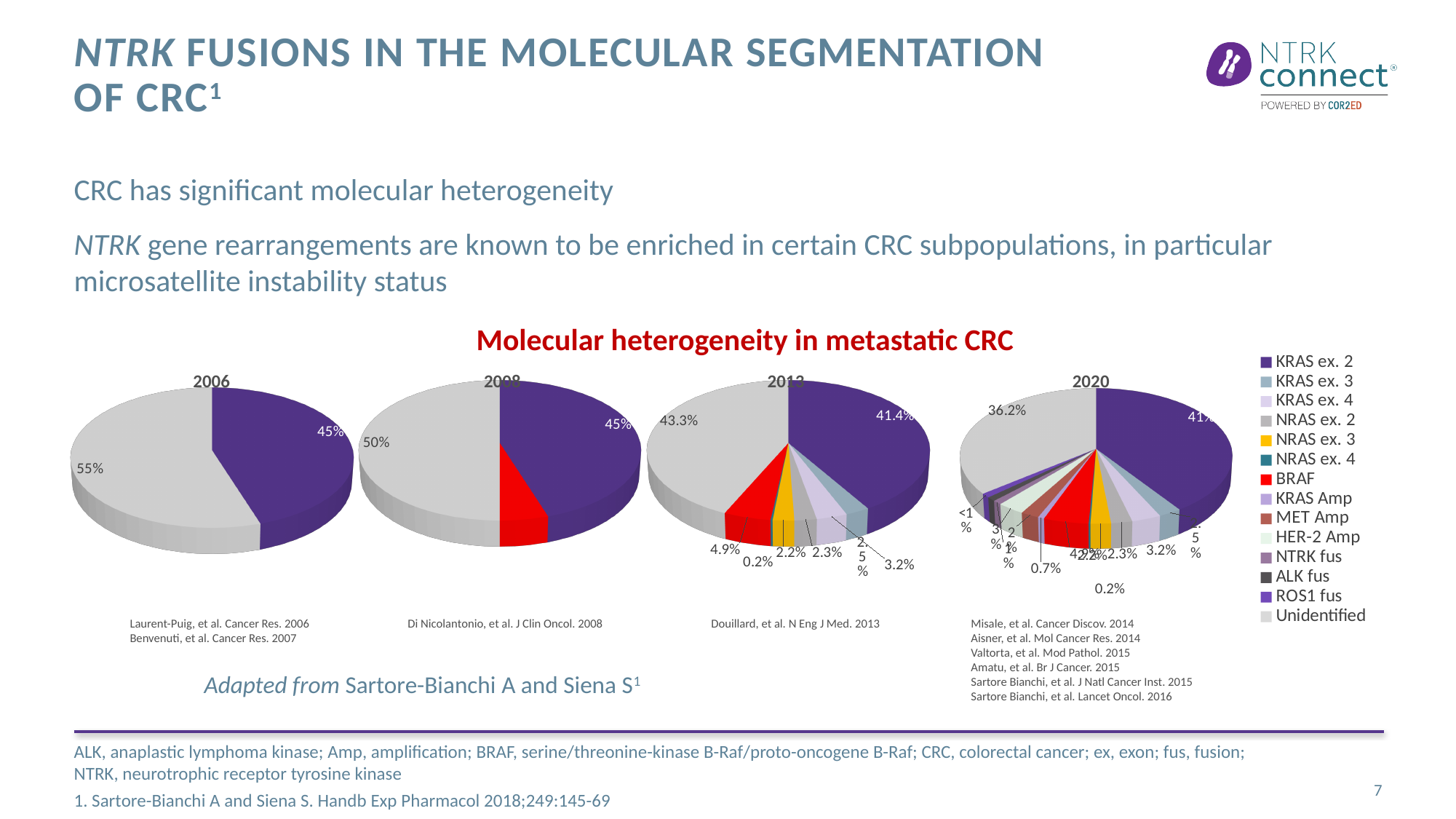
How many entries does the legend on the right list? 14 Across the four pie charts from 2006 to 2020, does the labelled share of the Unidentified slice rise or fall over time? Fall In the 2006 pie chart, which is larger: the Unidentified slice or the KRAS ex. 2 slice? Unidentified How many pie charts are shown on the slide? 4 In the 2020 pie chart, what share is labelled for the grey Unidentified slice? 36.2% In the 2013 pie chart, what share is labelled for the purple KRAS ex. 2 slice? 41.4% In the 2006 pie chart, what share is labelled for the grey Unidentified slice? 55% In the 2006 pie chart, what is the difference in percentage points between the Unidentified slice (55%) and the KRAS ex. 2 slice (45%)? 10 percentage points What kind of charts are shown under the title 'Molecular heterogeneity in metastatic CRC'? Pie charts